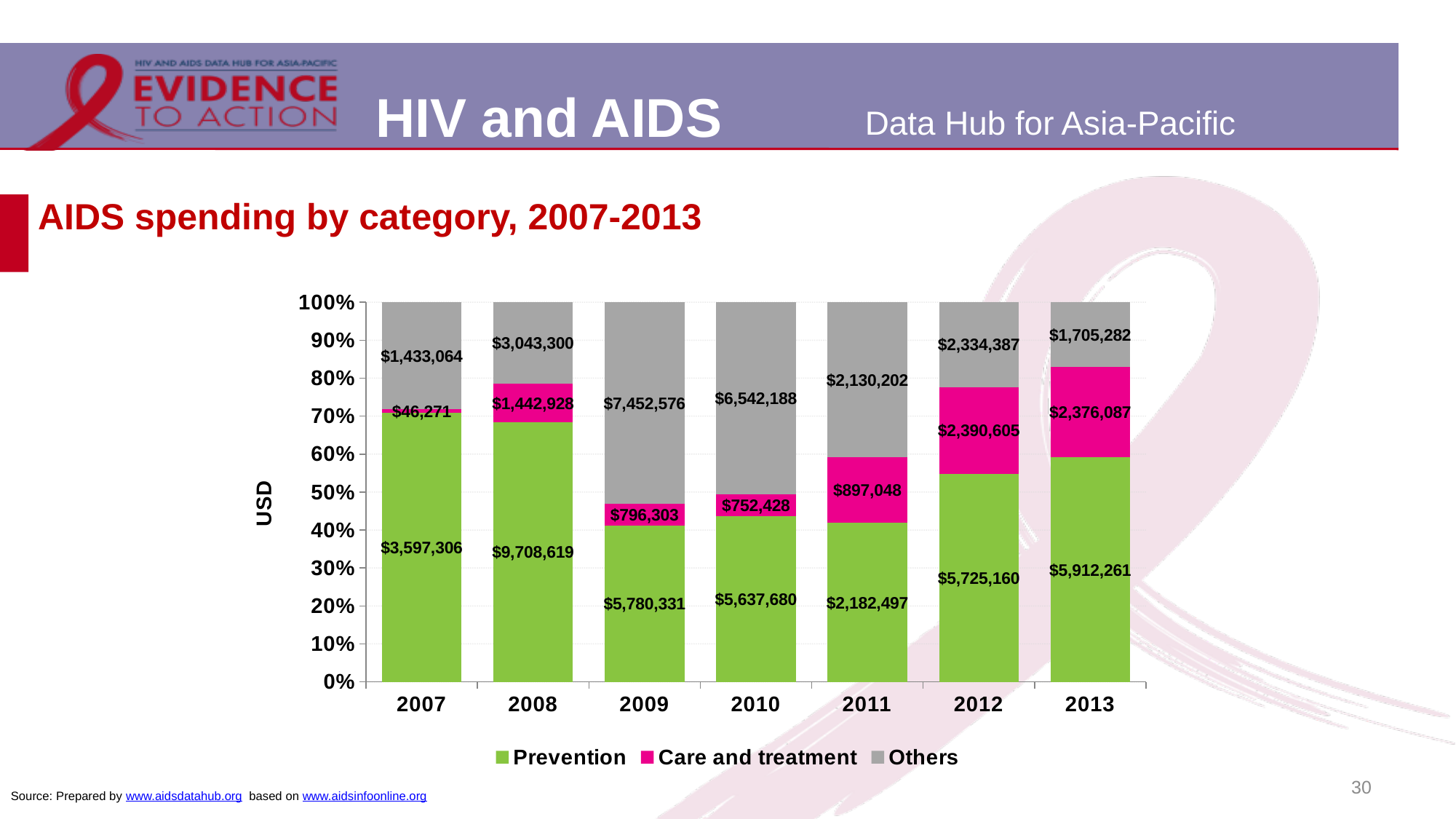
How many years are shown on the x axis? 7 What was the Others spending in 2009? $7,452,576 What was the Prevention spending in 2008? $9,708,619 What is the total AIDS spending across all three categories in 2007? $5,076,641 What is the difference between Prevention and Care and treatment spending in 2013? $3,536,174 What was the Care and treatment spending in 2013? $2,376,087 In which year was Care and treatment spending lowest? 2007 How many series does the legend list? 3 Which was larger in 2010: Prevention spending or Others spending? Others Is the Prevention share of spending in 2007 greater or less than 60%? greater In which year was Prevention spending highest? 2008 What was the Care and treatment spending in 2011? $897,048